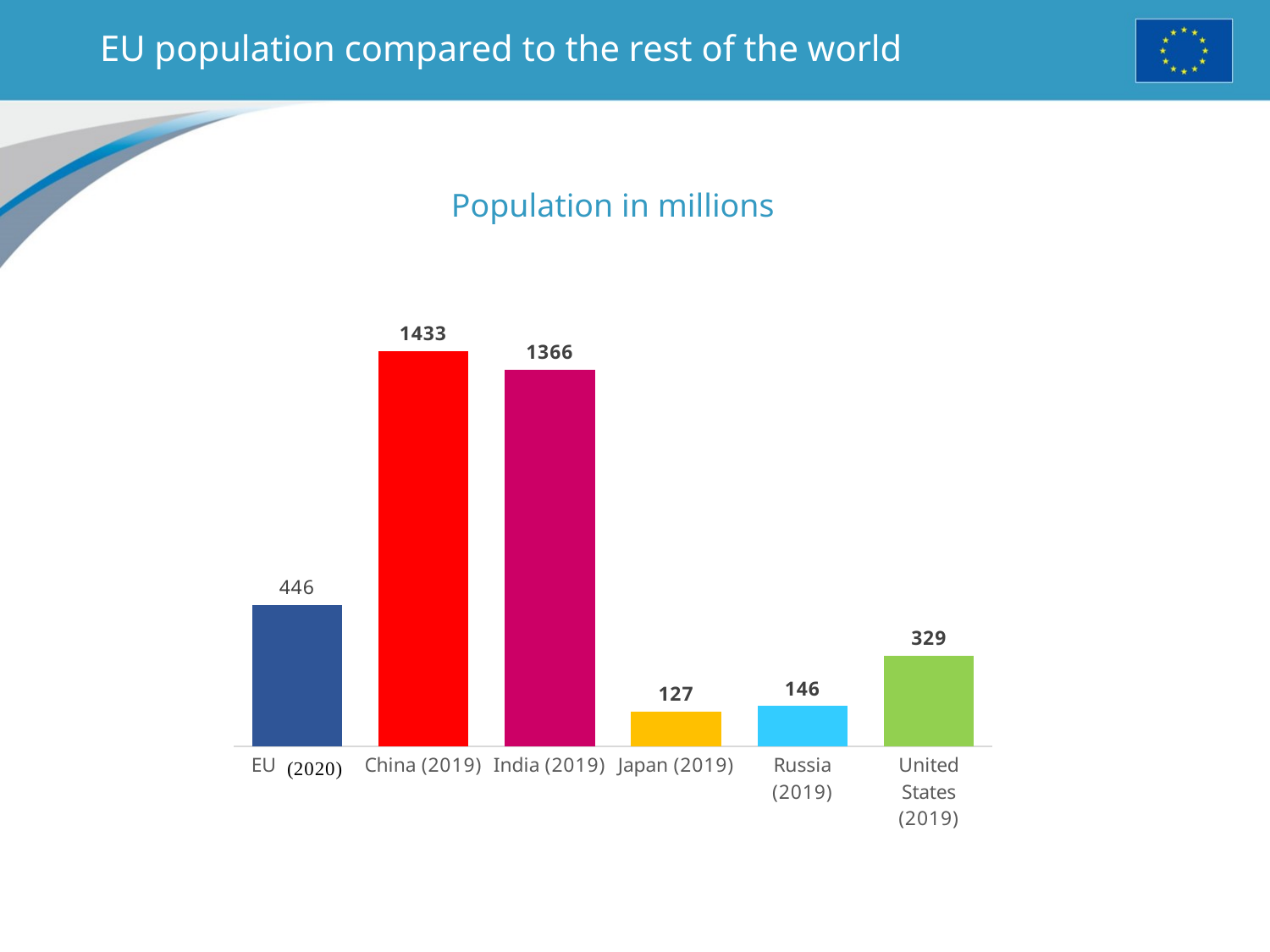
What is the population in millions shown for the EU (2020)? 446 Which category has the highest population in the chart? China (2019) What is the title of the chart? Population in millions What is the population in millions shown for the United States (2019)? 329 What is the difference in millions between the populations of the EU (2020) and the United States (2019)? 117 How many categories are shown in the chart? 6 Which has a larger population, Russia (2019) or Japan (2019)? Russia (2019) Which category has the lowest population in the chart? Japan (2019) What is the population in millions shown for Japan (2019)? 127 What is the difference in millions between the populations of China (2019) and India (2019)? 67 What is the population in millions shown for China (2019)? 1433 What kind of chart is shown on the slide? Bar chart